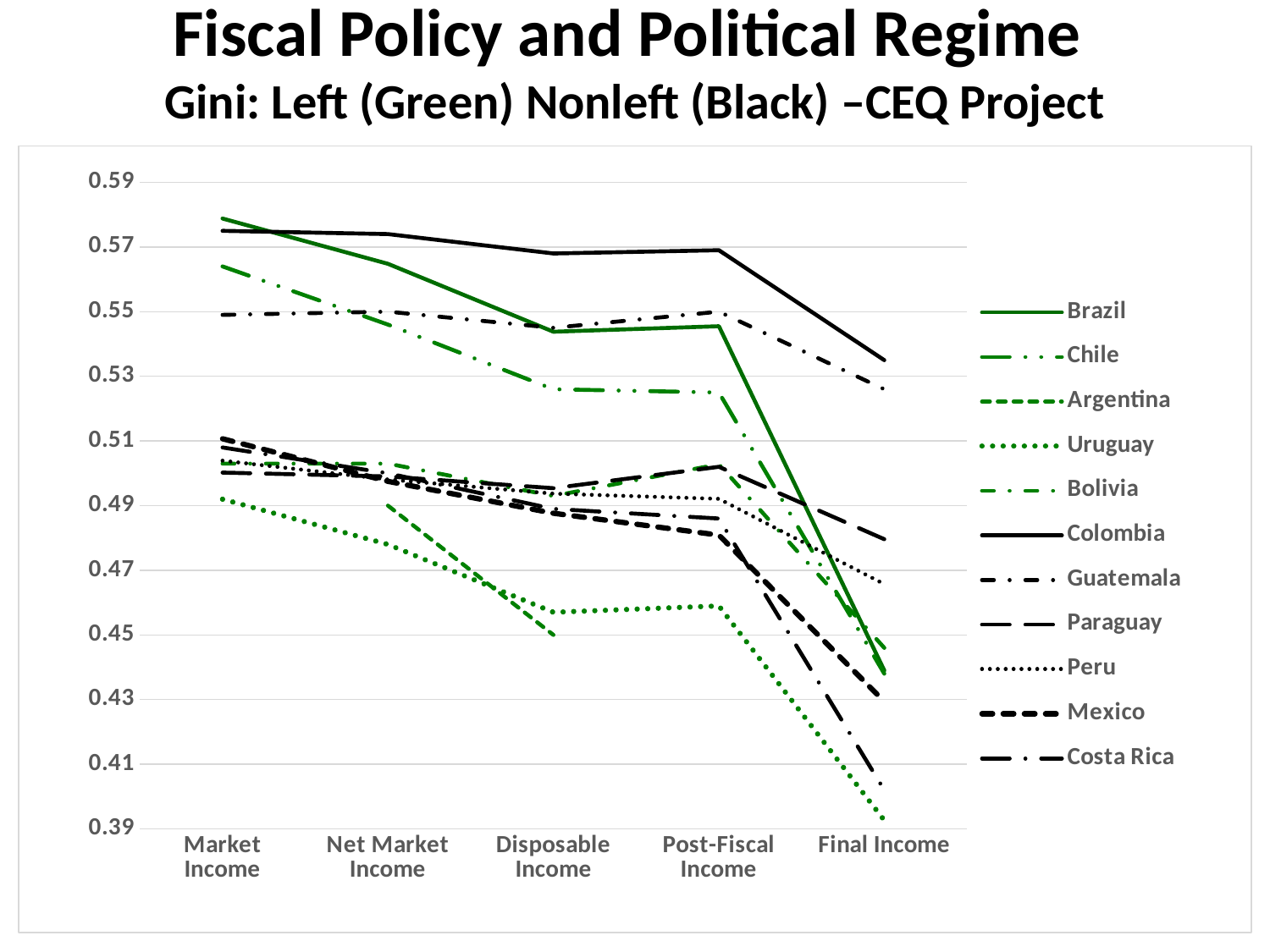
Is the value for Uruguay at Final Income greater or less than 0.41? less Is the value for Colombia at Market Income greater or less than 0.57? greater Which country has the lowest Gini value at Final Income? Uruguay At Final Income, which is larger: the value for Colombia or the value for Brazil? Colombia What kind of chart is shown on the slide? line chart Is the value for Chile at Market Income greater or less than 0.55? greater Which country has the lowest Gini value at Market Income? Uruguay How many income categories are shown on the x axis? 5 Does the Brazil line rise or fall from Market Income to Final Income? fall According to the subtitle, what colour are the lines for Left regimes? Green How many series does the legend list? 11 Which country has the highest Gini value at Post-Fiscal Income? Colombia